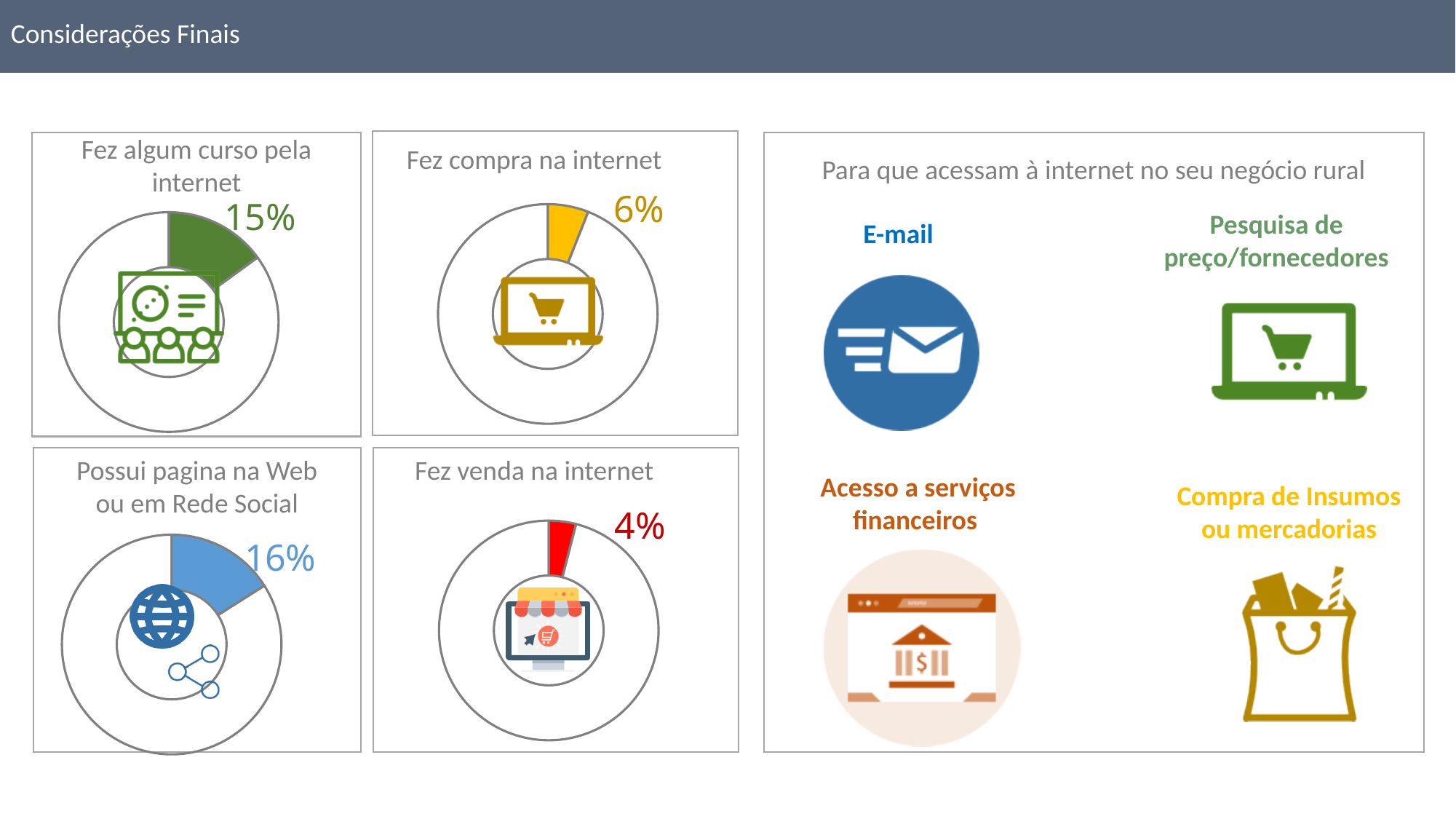
In the chart titled "Fez compra na internet", what percentage is shown? 6% Which of the four charts on the left shows the lowest percentage? Fez venda na internet Which of the four charts on the left shows the highest percentage? Possui pagina na Web ou em Rede Social Which is larger: the percentage in "Fez algum curso pela internet" or the percentage in "Possui pagina na Web ou em Rede Social"? Possui pagina na Web ou em Rede Social In the chart titled "Fez venda na internet", what percentage is shown? 4% In the chart titled "Possui pagina na Web ou em Rede Social", what percentage is shown? 16% What colour is the highlighted slice in the chart titled "Fez compra na internet"? Yellow What kind of chart is used in "Fez venda na internet"? Doughnut chart What is the difference between the percentage in "Possui pagina na Web ou em Rede Social" and the percentage in "Fez algum curso pela internet"? 1% How many pie charts are shown on the left side of the slide? 4 In the chart titled "Fez algum curso pela internet", what percentage is shown? 15% What is the difference between the percentage in "Fez compra na internet" and the percentage in "Fez venda na internet"? 2%